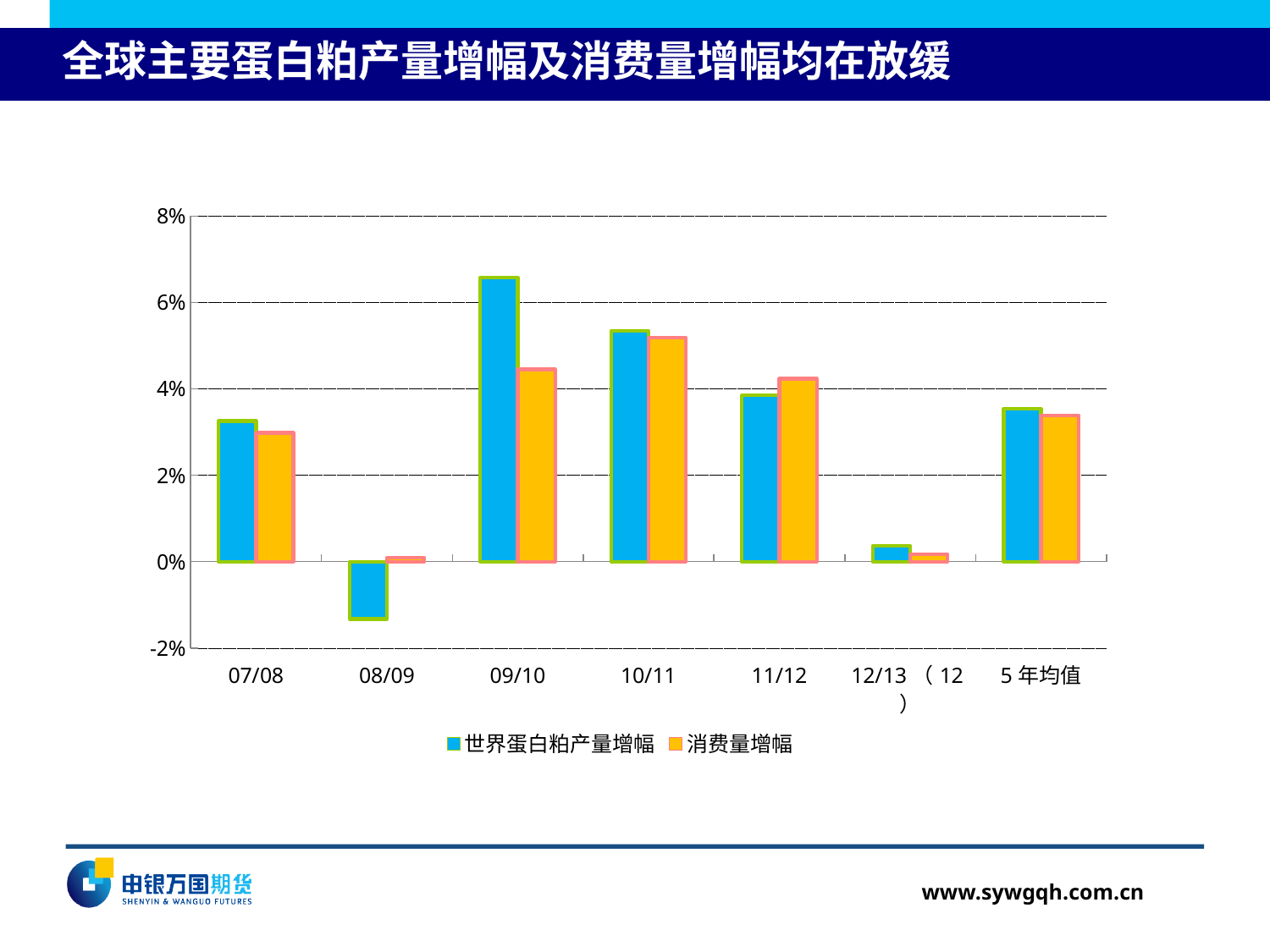
Is the value for 消费量增幅 in 11/12 greater or less than 4%? greater What is the title of the slide? 全球主要蛋白粕产量增幅及消费量增幅均在放缓 How many series does the legend list? 2 How many categories are shown on the x axis? 7 What kind of chart is shown on the slide? bar chart Is the value for 世界蛋白粕产量增幅 in 08/09 greater or less than 0%? less In 09/10, which is larger: 世界蛋白粕产量增幅 or 消费量增幅? 世界蛋白粕产量增幅 Is the value for 世界蛋白粕产量增幅 in 09/10 greater or less than 6%? greater In 08/09, which is larger: 世界蛋白粕产量增幅 or 消费量增幅? 消费量增幅 Which category has the lowest value for 世界蛋白粕产量增幅? 08/09 Which category has the highest value for 世界蛋白粕产量增幅? 09/10 Which category has the highest value for 消费量增幅? 10/11